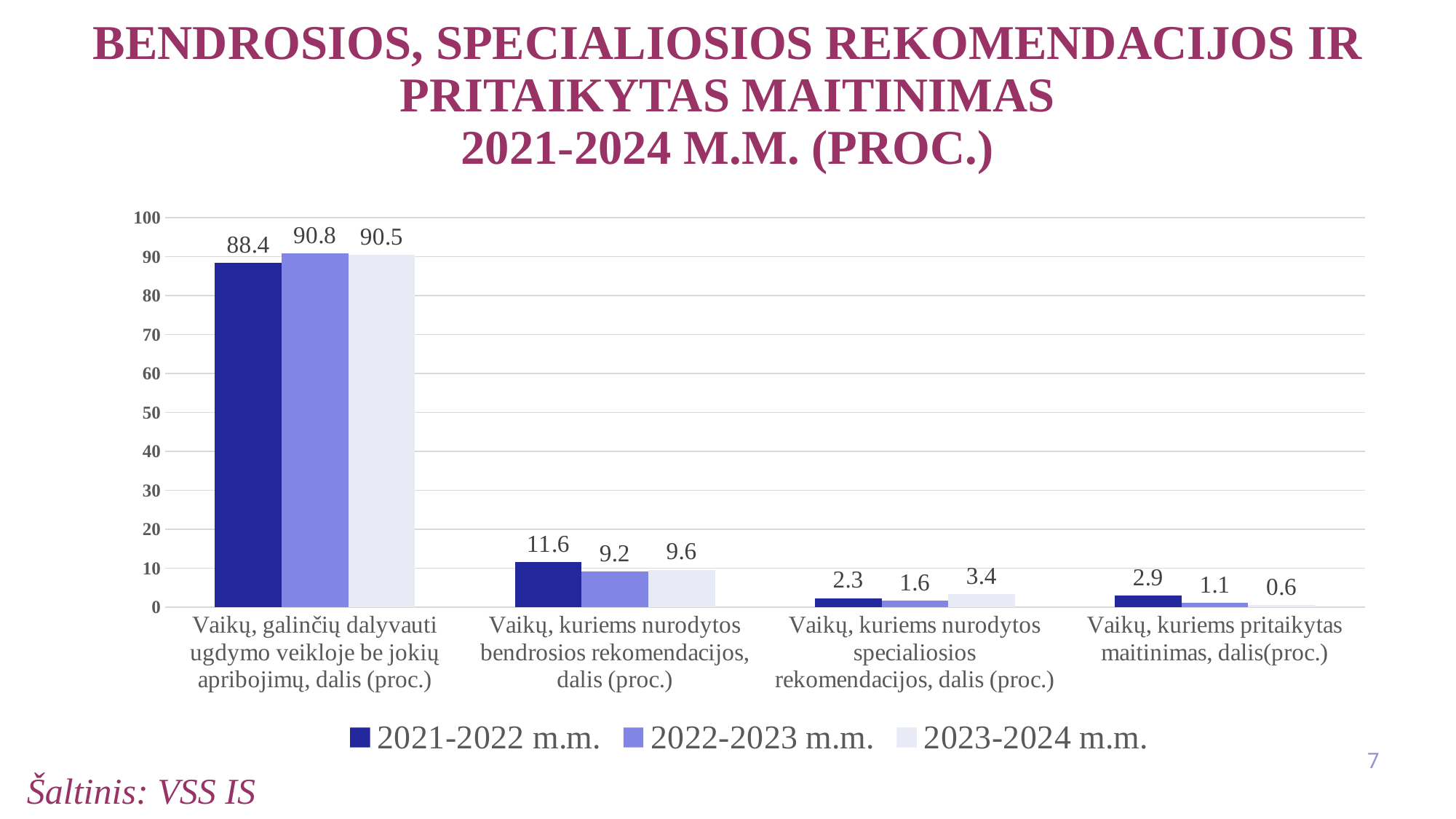
What is the 2023-2024 m.m. value for "Vaikų, kuriems pritaikytas maitinimas, dalis(proc.)"? 0.6 What is the 2021-2022 m.m. value for "Vaikų, galinčių dalyvauti ugdymo veikloje be jokių apribojimų, dalis (proc.)"? 88.4 What is the 2023-2024 m.m. value for "Vaikų, kuriems nurodytos bendrosios rekomendacijos, dalis (proc.)"? 9.6 How many categories are shown on the x axis? 4 How many series does the legend list? 3 Which series has the lowest value for "Vaikų, kuriems pritaikytas maitinimas, dalis(proc.)"? 2023-2024 m.m. Do the values for "Vaikų, kuriems pritaikytas maitinimas, dalis(proc.)" rise or fall from 2021-2022 m.m. to 2023-2024 m.m.? Fall What is the difference between the 2021-2022 m.m. and 2022-2023 m.m. values for "Vaikų, kuriems nurodytos bendrosios rekomendacijos, dalis (proc.)"? 2.4 Which series has the highest value for "Vaikų, galinčių dalyvauti ugdymo veikloje be jokių apribojimų, dalis (proc.)"? 2022-2023 m.m. What is the 2022-2023 m.m. value for "Vaikų, kuriems nurodytos specialiosios rekomendacijos, dalis (proc.)"? 1.6 What kind of chart is shown on the slide? Bar chart Which is larger for "Vaikų, kuriems nurodytos specialiosios rekomendacijos, dalis (proc.)": the 2021-2022 m.m. value or the 2023-2024 m.m. value? 2023-2024 m.m.